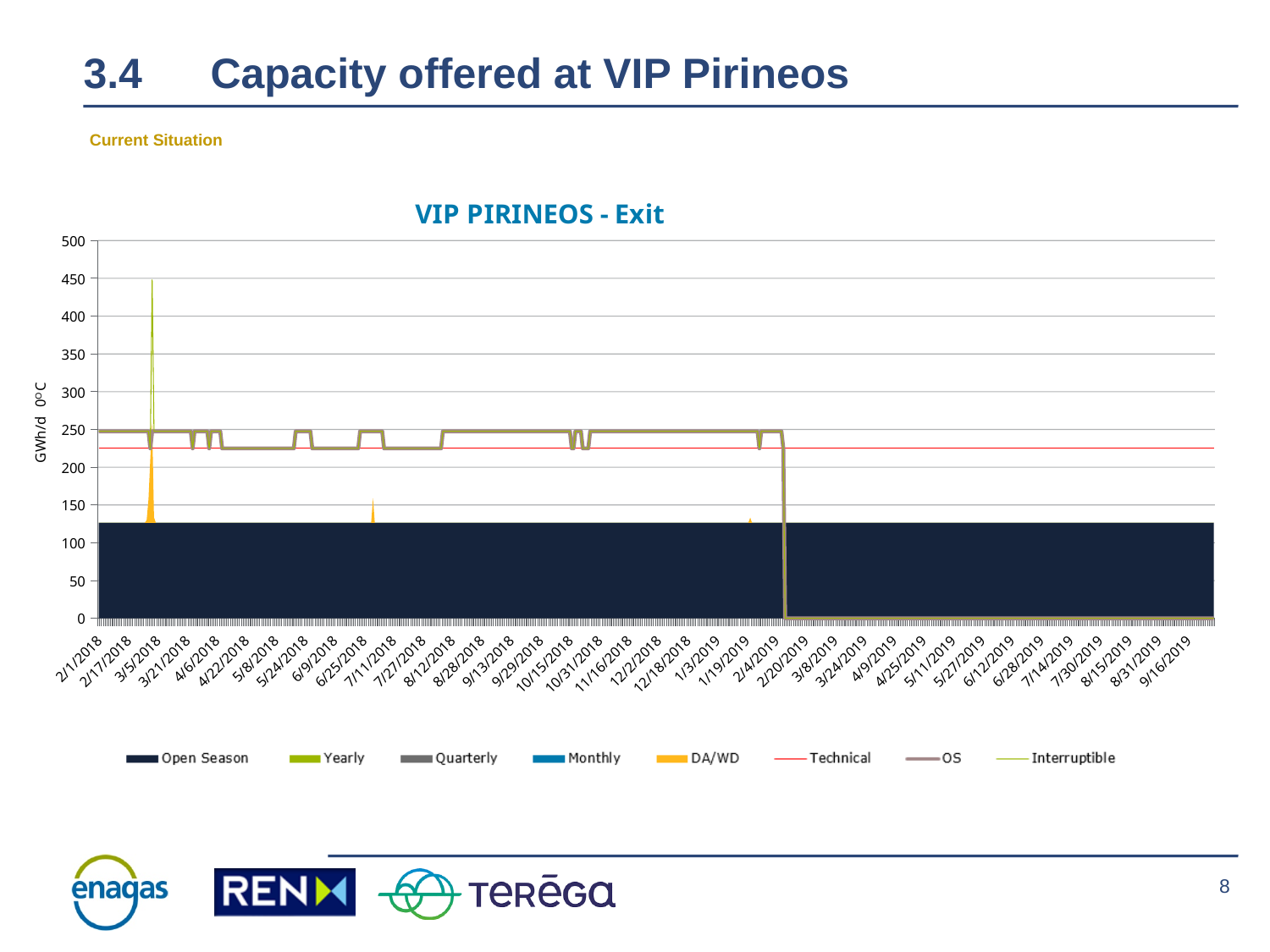
What is the title of the chart on the slide? VIP PIRINEOS - Exit Is the Open Season value during 2018 greater or less than 150? less What unit is shown on the vertical axis of the chart? GWh/d 0°C Is the OS line value in mid-2018 greater or less than 200? greater Is the Open Season value during 2018 greater or less than 100? greater Does the OS line rise or fall around 2/20/2019? falls How many series does the chart legend list? 8